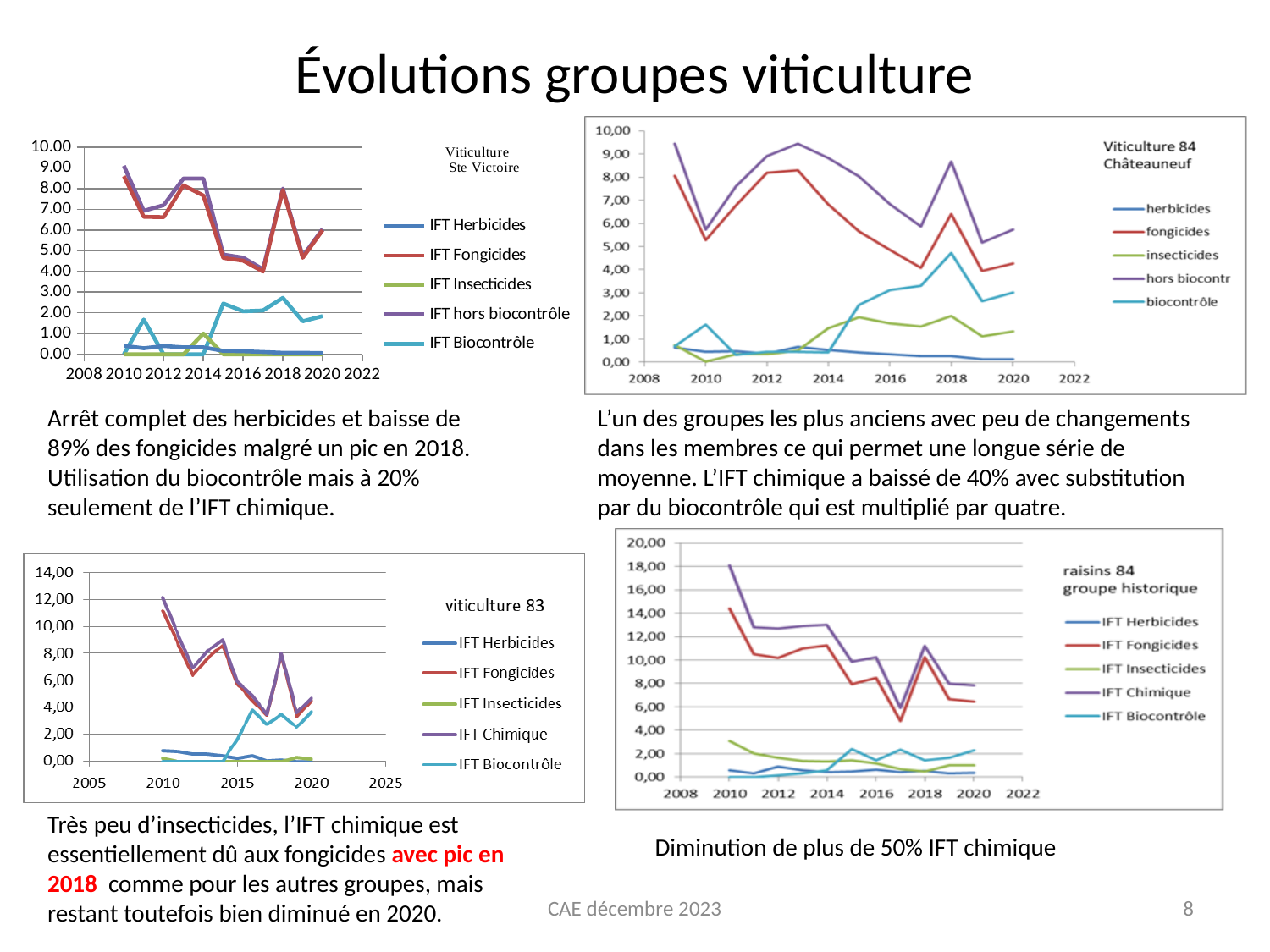
What kind of chart is the 'Viticulture Ste Victoire' chart at the top left? Line chart In the 'Viticulture 84 Châteauneuf' chart, is the value of hors biocontr in 2013 greater or less than 8,00? greater In the 'viticulture 83' chart, is the value of IFT Chimique in 2010 greater or less than 10,00? greater In the 'raisins 84 groupe historique' chart, which series has the highest value in 2010? IFT Chimique In the 'Viticulture Ste Victoire' chart, which is larger in 2018: IFT Fongicides or IFT Biocontrôle? IFT Fongicides In the 'raisins 84 groupe historique' chart, is the value of IFT Chimique in 2010 greater or less than 16,00? greater What is the title shown on the bottom-left chart? viticulture 83 How many series does the legend of the 'Viticulture 84 Châteauneuf' chart list? 5 In the 'viticulture 83' chart, which series is drawn in green according to the legend? IFT Insecticides In the 'Viticulture 84 Châteauneuf' chart, does the biocontrôle series overall rise or fall between 2009 and 2020? Rise In the 'raisins 84 groupe historique' chart, does the IFT Chimique series overall rise or fall between 2010 and 2020? Fall